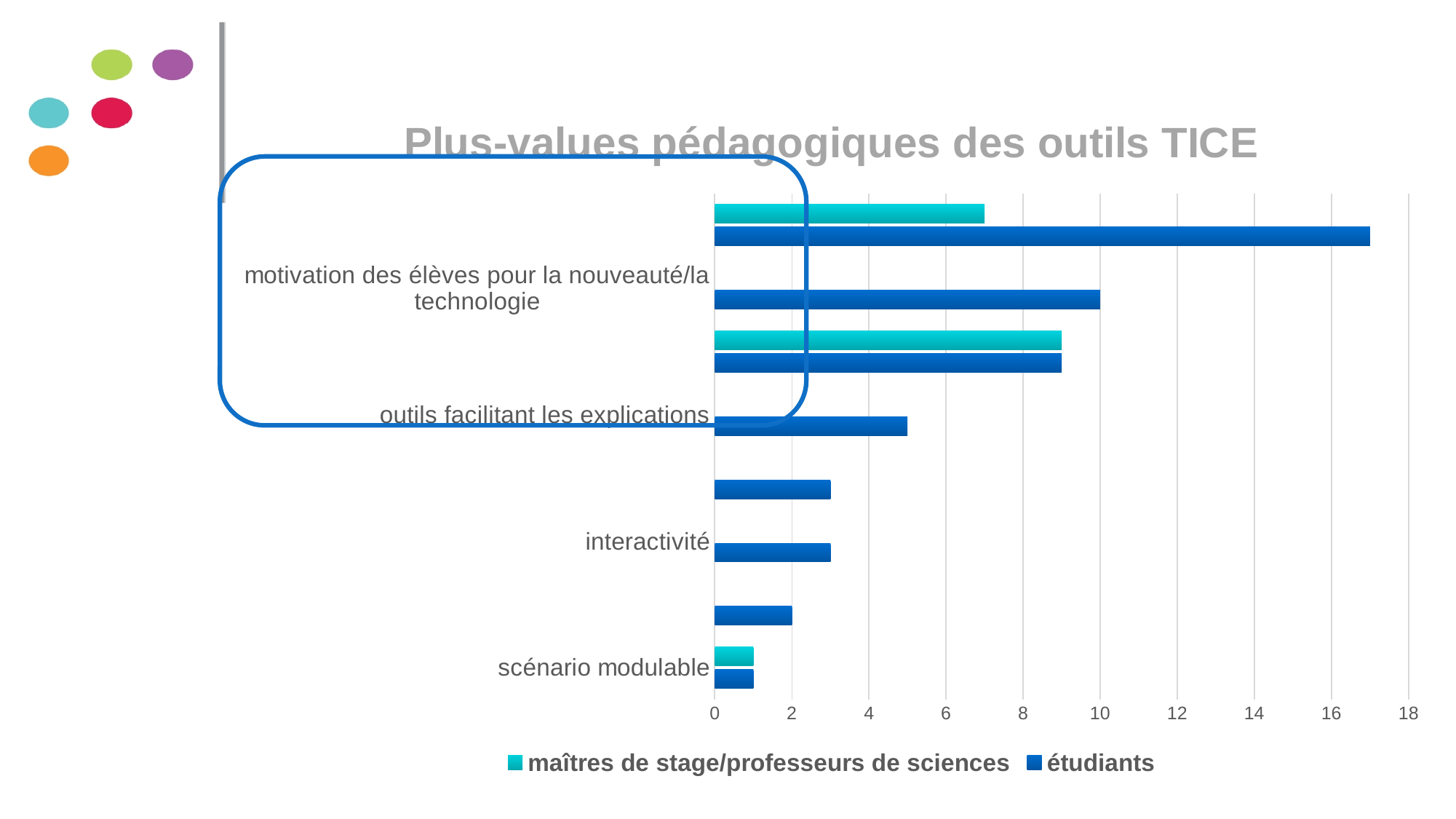
What kind of chart is shown on the slide? bar chart For the étudiants series, which is larger: 'interactivité' or 'scénario modulable'? interactivité For the étudiants series, which is larger: 'motivation des élèves pour la nouveauté/la technologie' or 'outils facilitant les explications'? motivation des élèves pour la nouveauté/la technologie What is the étudiants value for 'motivation des élèves pour la nouveauté/la technologie'? 10 Is the étudiants value for 'outils facilitant les explications' greater or less than 4? greater What are the two series named in the legend? maîtres de stage/professeurs de sciences; étudiants How many series does the legend list? 2 Is the maîtres de stage/professeurs de sciences value for 'scénario modulable' greater or less than 2? less What is the title of the chart? Plus-values pédagogiques des outils TICE Is the étudiants value for 'interactivité' greater or less than 4? less Of the four labelled categories, which has the highest étudiants value? motivation des élèves pour la nouveauté/la technologie